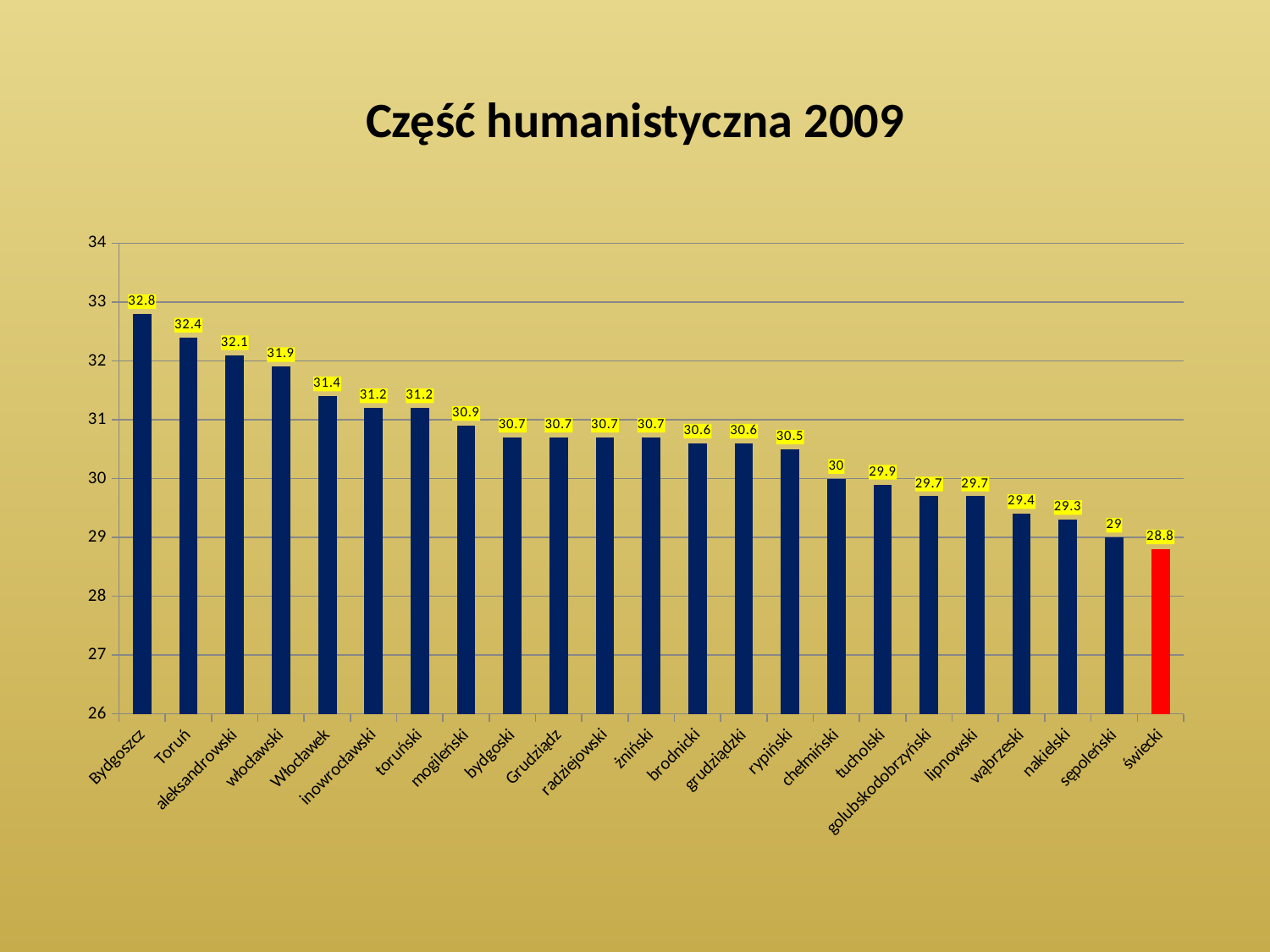
Which category has the highest value? Bydgoszcz Which is larger, the value for tucholski or the value for wąbrzeski? tucholski What is the difference between the values for Bydgoszcz and świecki? 4 What is the value for chełmiński? 30 How many categories are shown on the x axis? 23 What is the value for mogileński? 30.9 What is the value for świecki? 28.8 What is the value for Bydgoszcz? 32.8 What kind of chart is shown on the slide? bar chart Do the values rise or fall from left to right along the x axis? fall Which category has the lowest value? świecki What is the difference between the values for Toruń and Włocławek? 1